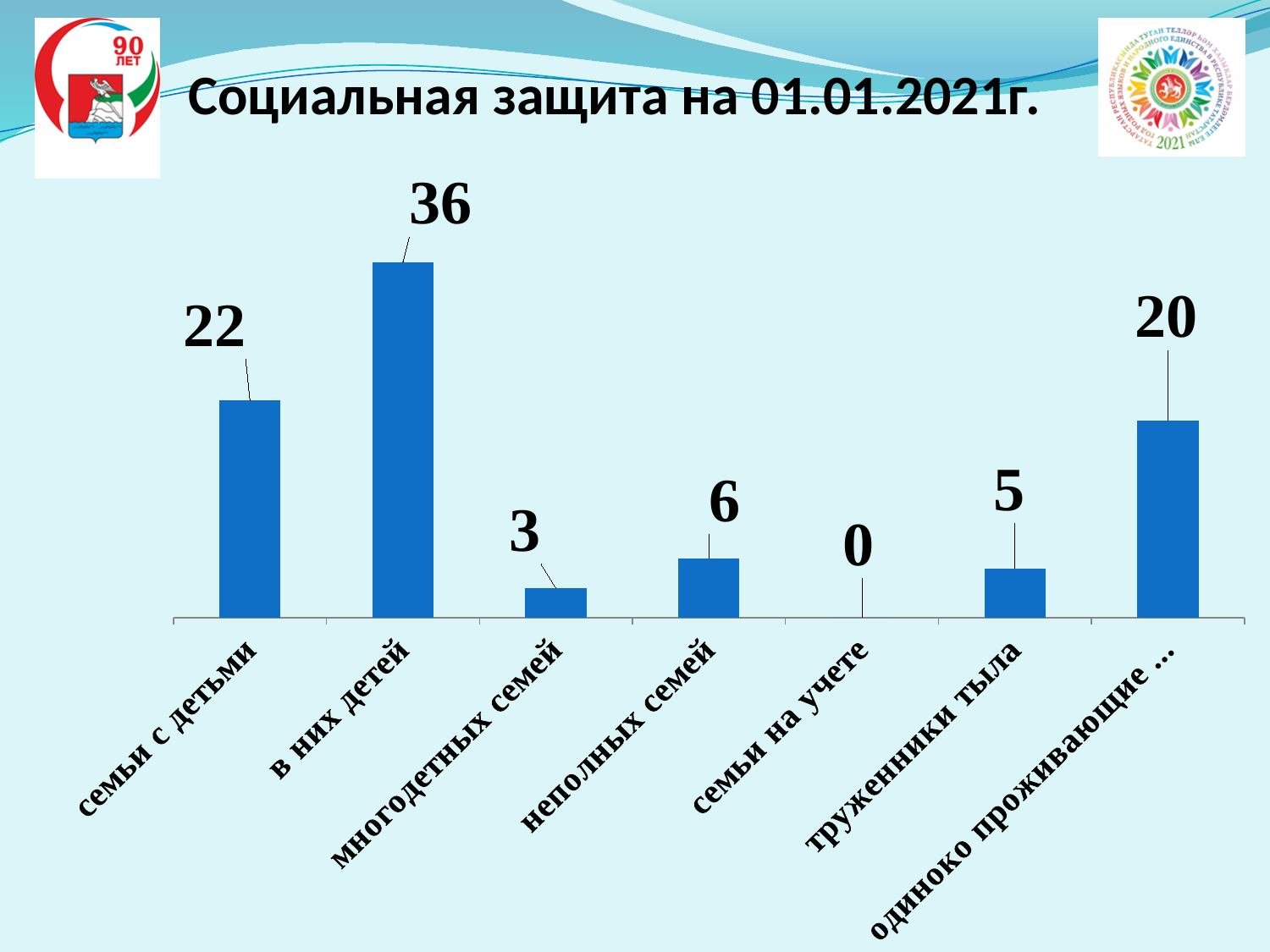
What is the value for "труженники тыла"? 5 Which category has the lowest value? семьи на учете Which category has the highest value? в них детей What kind of chart is shown on the slide? bar chart What is the difference between the values for "в них детей" and "семьи с детьми"? 14 What is the value for "семьи с детьми"? 22 How many categories are shown in the chart? 7 What is the value for "неполных семей"? 6 What is the value for "в них детей"? 36 What is the value for "семьи на учете"? 0 Which is larger, the value for "неполных семей" or the value for "труженники тыла"? неполных семей What is the value for "многодетных семей"? 3